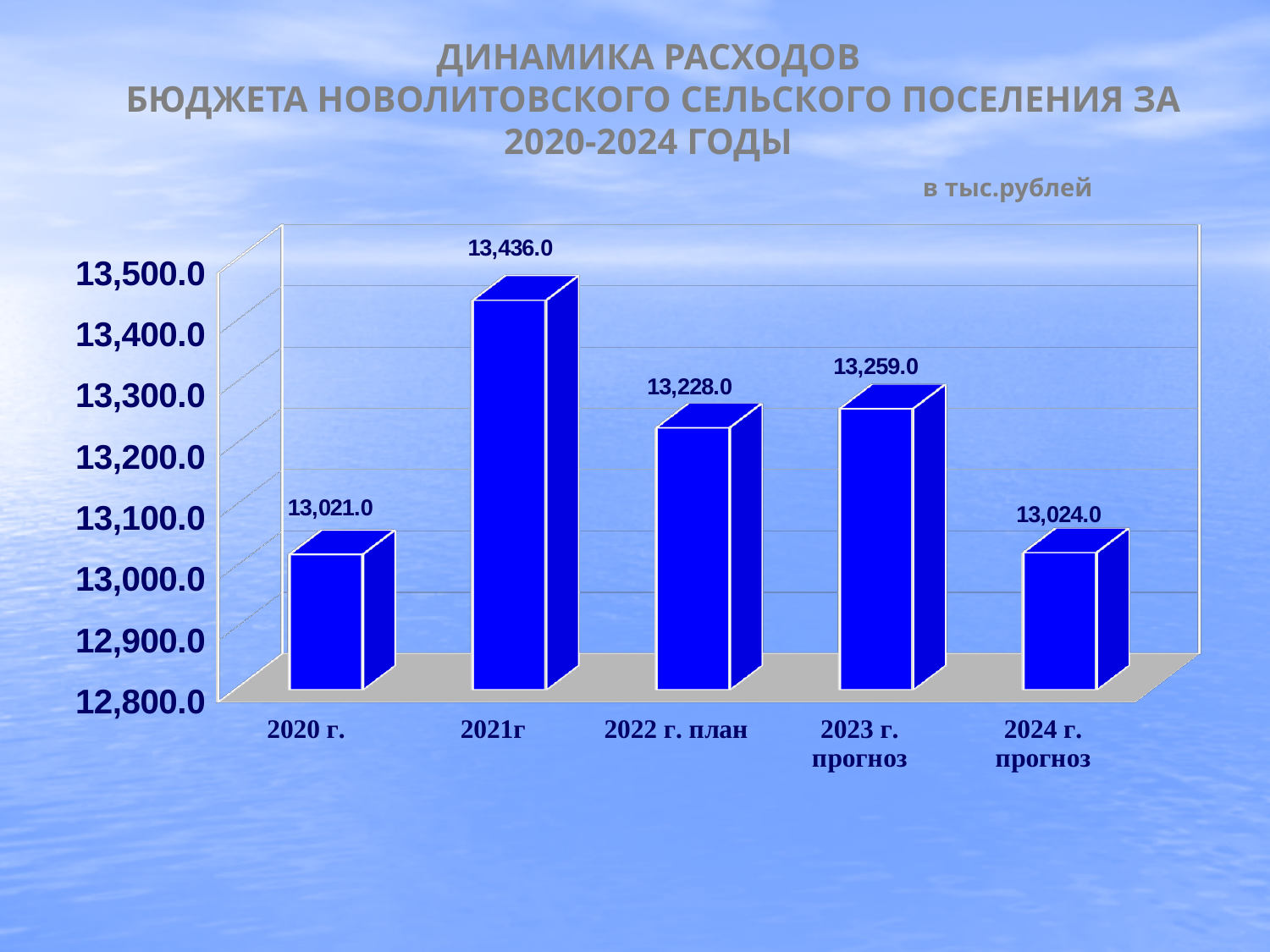
How many categories are shown on the x axis? 5 What is the value for 2022 г. план? 13,228.0 What is the difference between the values for 2023 г. прогноз and 2022 г. план? 31.0 What is the value for 2021г? 13,436.0 What is the value for 2024 г. прогноз? 13,024.0 Is the value for 2022 г. план greater or less than 13,300.0? less Which is larger, the value for 2023 г. прогноз or the value for 2024 г. прогноз? 2023 г. прогноз Which category has the highest value? 2021г What is the difference between the values for 2021г and 2020 г.? 415.0 In what units are the values on the chart expressed? тыс.рублей Which category has the lowest value? 2020 г. What kind of chart is shown on the slide? bar chart